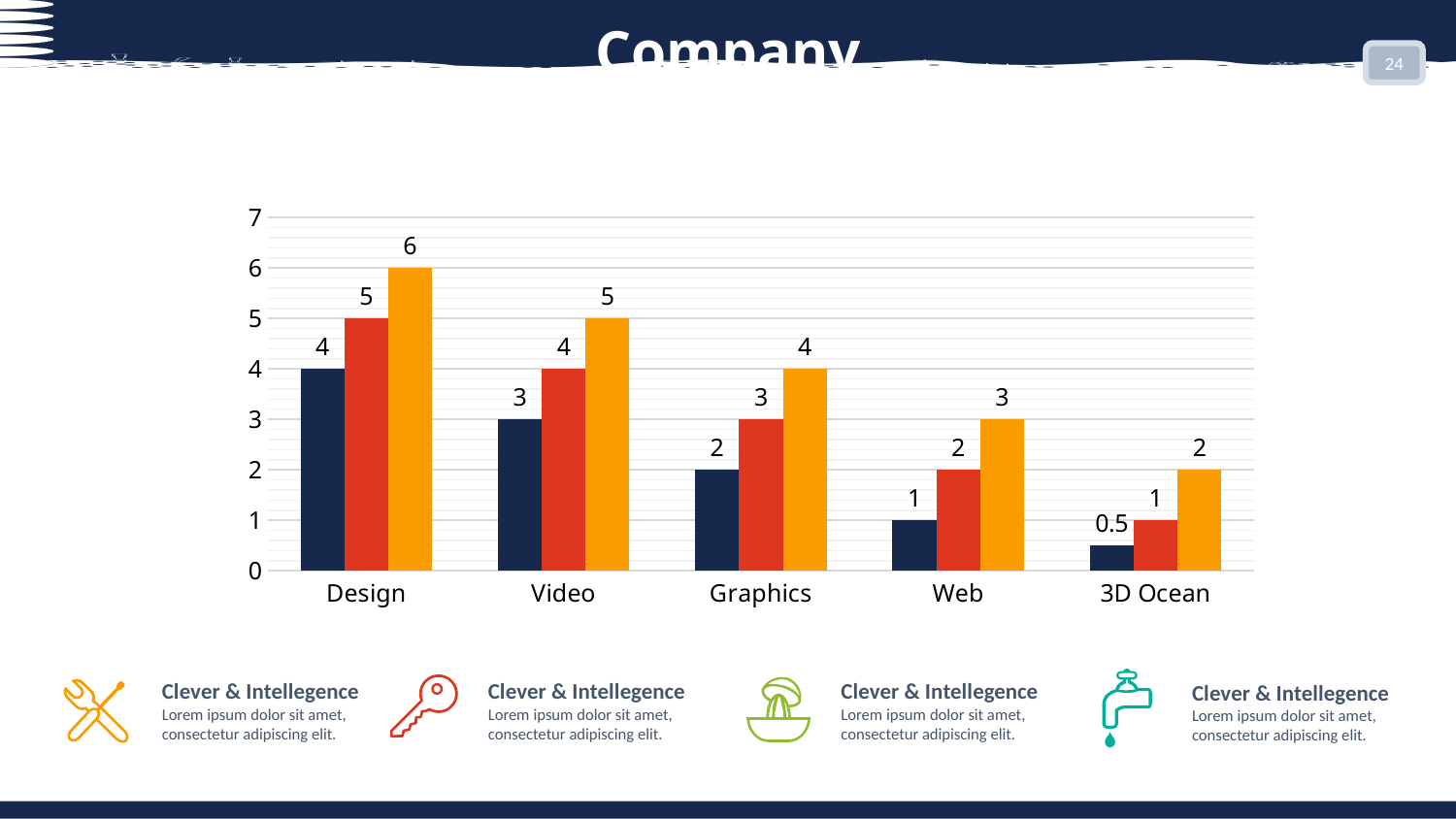
What is the difference between the orange bar for Design and the orange bar for Web? 3 What is the value of the orange bar for Design? 6 Do the orange bar values rise or fall from Design to 3D Ocean? Fall What is the total of the three bars for Web? 6 Which category has the lowest dark blue bar? 3D Ocean What type of chart is shown on the slide? Bar chart What is the value of the dark blue bar for 3D Ocean? 0.5 Which category has the highest orange bar? Design How many categories are shown on the x axis? 5 Which is larger: the red bar for Video or the red bar for Web? Video What is the value of the red bar for Graphics? 3 How many bars are shown for each category? 3